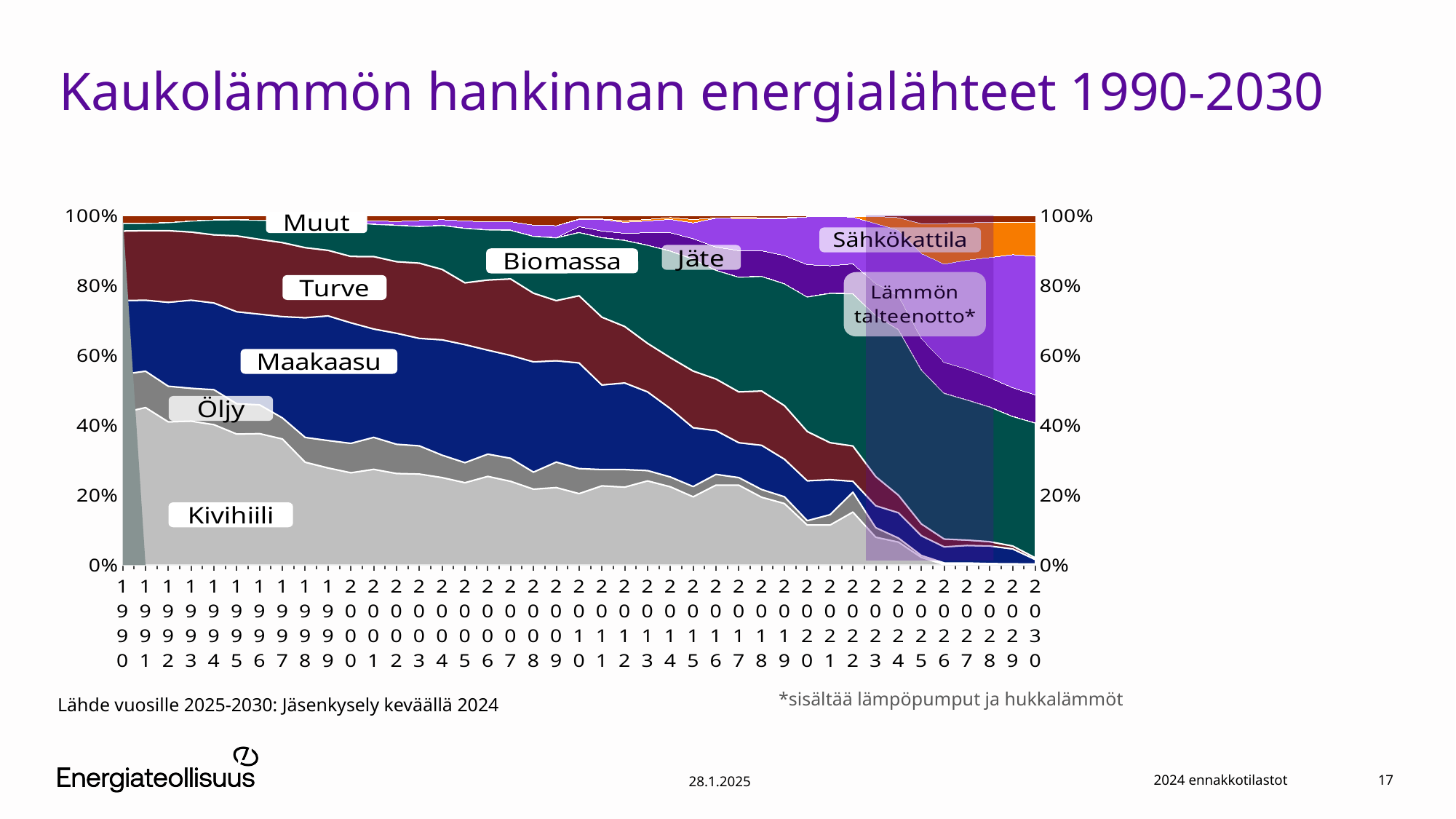
In 2000, which has the larger share: Kivihiili or Öljy? Kivihiili Is the share of Kivihiili in 2020 greater or less than 20%? less What is the title of the chart? Kaukolämmön hankinnan energialähteet 1990-2030 What kind of chart is shown on the slide? Stacked area chart Does the share of Biomassa rise or fall from 1990 to 2030? Rise What is the maximum value shown on the y axis? 100% In 2020, which has the larger share: Biomassa or Turve? Biomassa Does the share of Kivihiili rise or fall from 1991 to 2030? Fall How many years are shown along the x axis? 41 How many energy source series are labelled on the chart? 9 Is the share of Kivihiili in 2000 greater or less than 40%? less